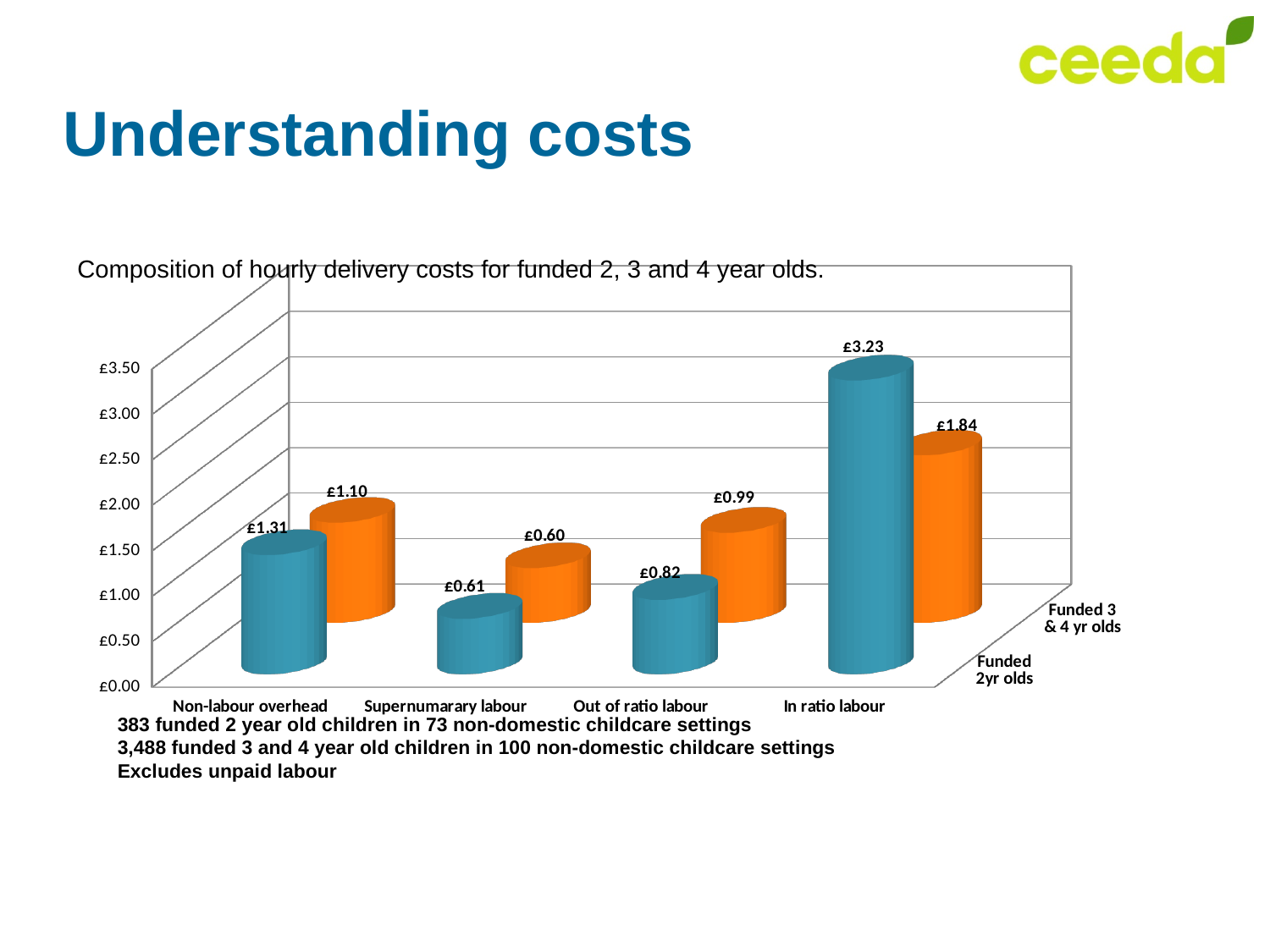
Which cost category has the highest value for Funded 2yr olds? In ratio labour Which is larger: the Out of ratio labour cost for Funded 2yr olds or for Funded 3 & 4 yr olds? Funded 3 & 4 yr olds What is the difference between the In ratio labour cost for Funded 2yr olds and for Funded 3 & 4 yr olds? £1.39 Which cost category has the lowest value for Funded 3 & 4 yr olds? Supernumarary labour What is the hourly cost of Non-labour overhead for Funded 3 & 4 yr olds? £1.10 Is the In ratio labour value for Funded 2yr olds greater or less than £3.00? greater What type of chart is shown on the slide? Bar chart How many cost categories are shown on the x axis? 4 What is the value for Supernumarary labour for Funded 2yr olds? £0.61 What is the value for Out of ratio labour for Funded 3 & 4 yr olds? £0.99 What is the hourly cost of In ratio labour for Funded 2yr olds? £3.23 How many data series (age groups) are plotted in the chart? 2